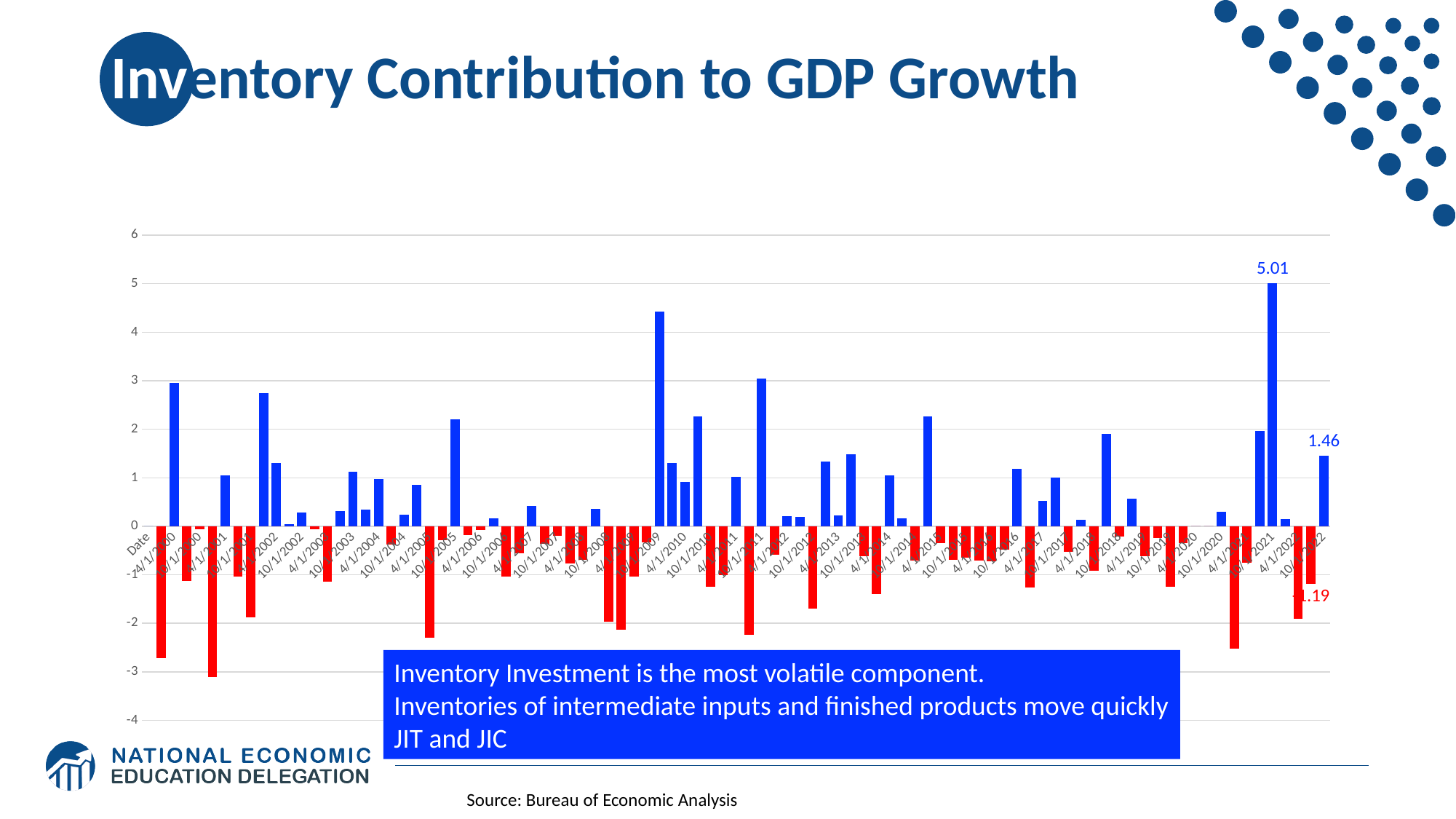
What is the value printed on the labeled red (negative) bar near the right end of the chart? -1.19 What colour are the negative bars on the chart? red Is the lowest value on the chart greater or less than -3? less What is the value of the tallest bar on the chart? 5.01 Is the value of the rightmost bar (1.46) greater or less than 1? greater Which is larger: the bar labeled 5.01 or the bar labeled 1.46? the bar labeled 5.01 What is the difference between the tallest bar (5.01) and the rightmost bar (1.46)? 3.55 What is the title of the slide? Inventory Contribution to GDP Growth Is the value of the labeled red bar (-1.19) greater or less than -1? less What kind of chart is shown on the slide? bar chart What is the value of the last (rightmost) bar on the chart? 1.46